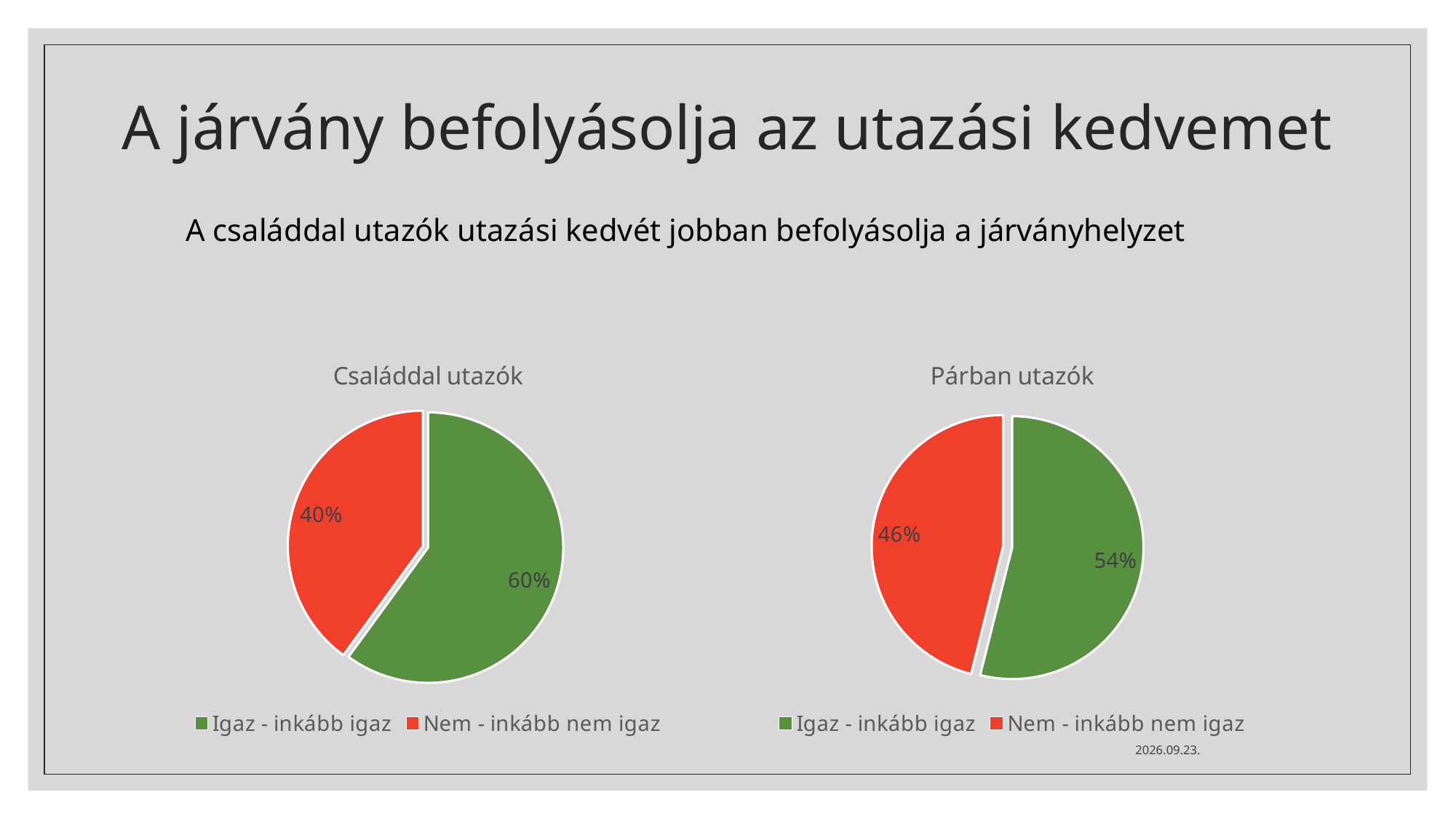
In the 'Családdal utazók' chart, what share is labelled for 'Nem - inkább nem igaz'? 40% How many slices does the 'Családdal utazók' pie chart have? 2 In the 'Párban utazók' chart, which slice is the smallest? Nem - inkább nem igaz In the 'Párban utazók' chart, what share is labelled for 'Igaz - inkább igaz'? 54% In the 'Családdal utazók' chart, what share is labelled for 'Igaz - inkább igaz'? 60% What kind of chart is the 'Párban utazók' chart? Pie chart Which chart has the larger 'Igaz - inkább igaz' share, 'Családdal utazók' or 'Párban utazók'? Családdal utazók In the 'Párban utazók' chart, what is the difference between the 'Igaz - inkább igaz' and 'Nem - inkább nem igaz' shares? 8% In the 'Családdal utazók' chart, which slice is the largest? Igaz - inkább igaz In the 'Párban utazók' chart, what share is labelled for 'Nem - inkább nem igaz'? 46% What colour is the 'Nem - inkább nem igaz' slice in the 'Párban utazók' chart? Red In the 'Családdal utazók' chart, what is the difference between the 'Igaz - inkább igaz' and 'Nem - inkább nem igaz' shares? 20%